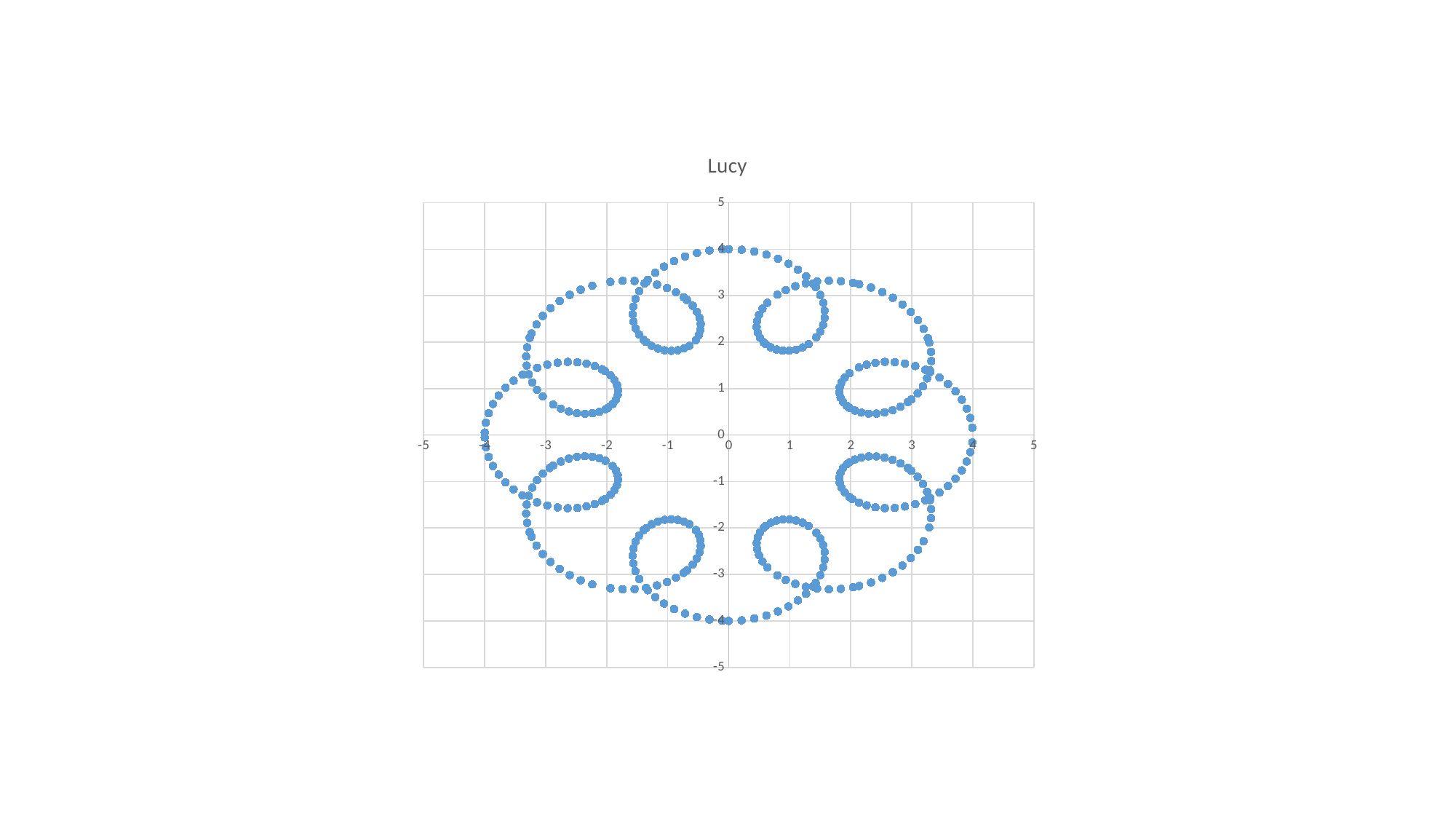
Is the largest x value reached by the plotted points greater or less than 3? greater What is the title of the chart? Lucy How many small loops does the plotted curve form around the centre? 8 What range does the x axis of the chart cover? -5 to 5 What kind of chart is shown on the slide? scatter chart Is the smallest x value reached by the plotted points greater or less than -5? greater Is the smallest y value reached by the plotted points greater or less than -3? less